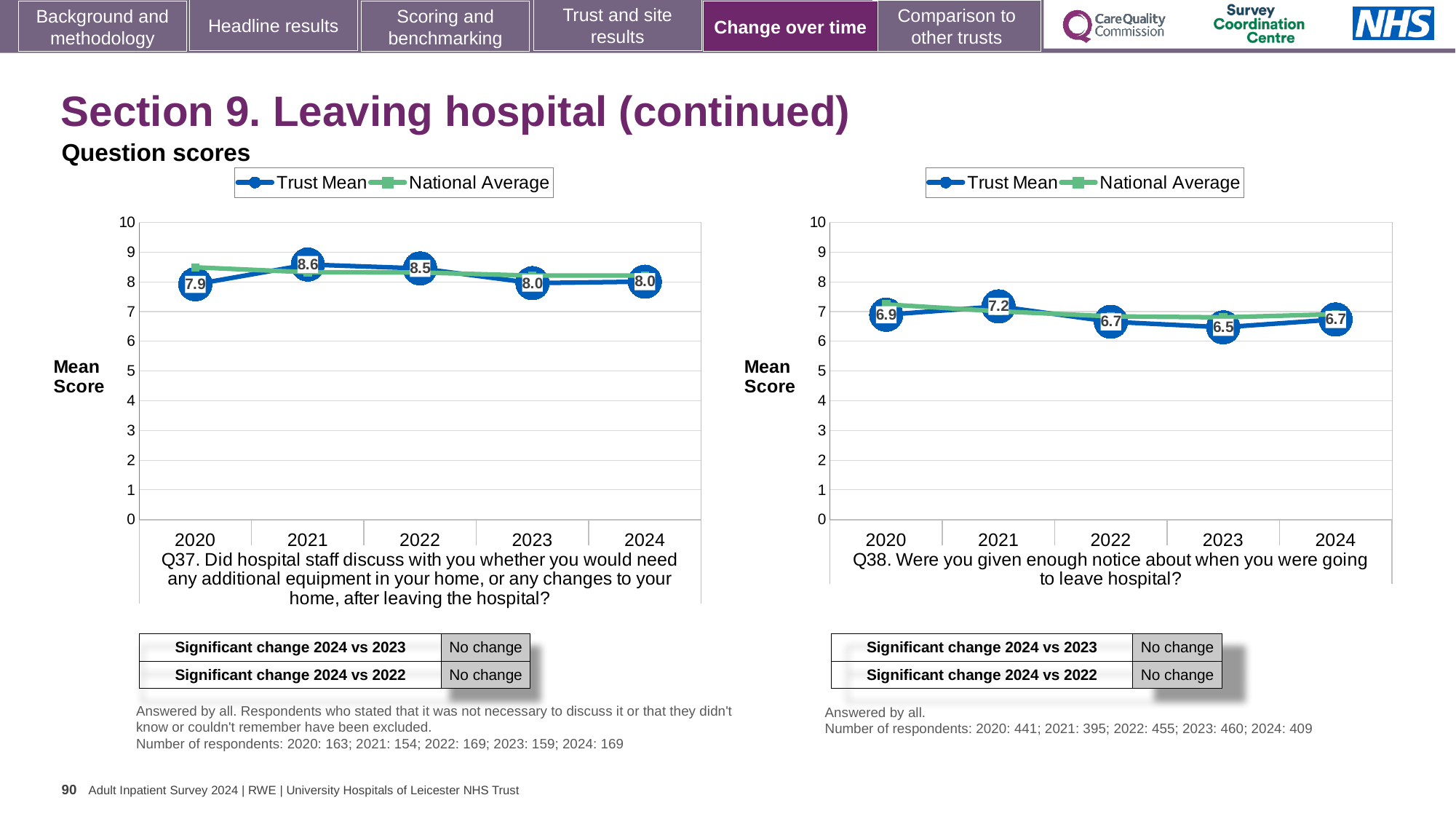
In the Q38 chart on the right, is the Trust Mean value for 2020 greater or less than 8? less In the Q38 chart on the right, what is the Trust Mean score for 2023? 6.5 In the Q37 chart on the left, what is the Trust Mean score for 2020? 7.9 How many series does the legend of the Q38 chart on the right list? 2 In the Q38 chart on the right, which year has the lowest Trust Mean score? 2023 In the Q37 chart on the left, which year has the highest Trust Mean score? 2021 What kind of chart is the Q37 chart on the left? Line chart How many years are shown on the x axis of the Q37 chart on the left? 5 In the Q38 chart on the right, what is the Trust Mean score for 2024? 6.7 In the Q38 chart on the right, is the Trust Mean score for 2021 larger or smaller than the score for 2022? larger In the Q37 chart on the left, what is the Trust Mean score for 2021? 8.6 In the Q37 chart on the left, what is the difference between the Trust Mean scores for 2021 and 2020? 0.7